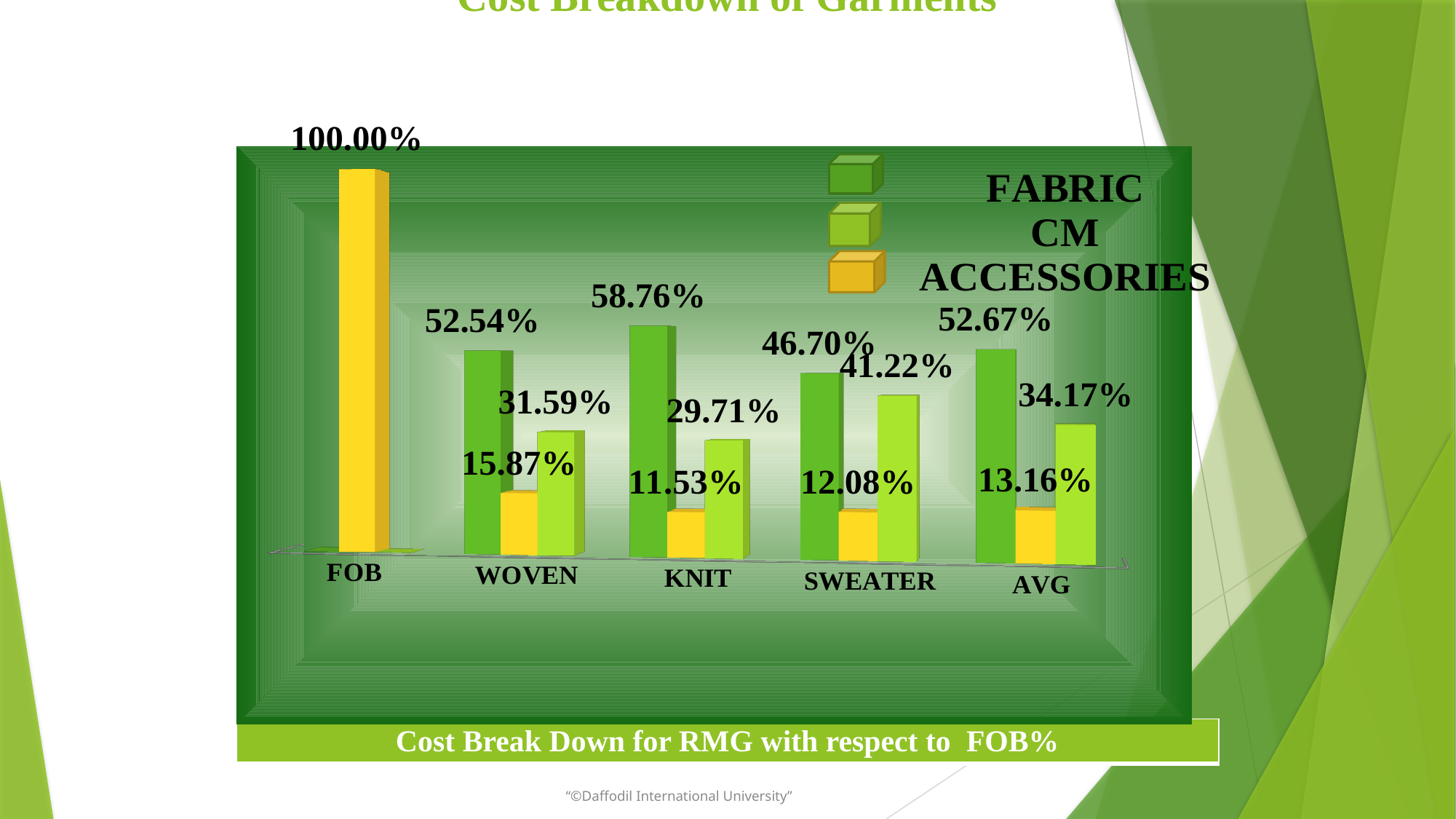
What value is shown for FOB? 100.00% What is the difference between the FABRIC value for WOVEN and the FABRIC value for SWEATER? 5.84% Which has the larger CM value, SWEATER or WOVEN? SWEATER How many categories are shown on the x axis? 5 What kind of chart is this? Bar chart What is the ACCESSORIES value for WOVEN? 15.87% Which category has the highest FABRIC value? KNIT What is the CM value for SWEATER? 41.22% Which category has the lowest ACCESSORIES value? KNIT How many series does the legend list? 3 What is the caption shown below the chart? Cost Break Down for RMG with respect to FOB% What is the FABRIC value for KNIT? 58.76%